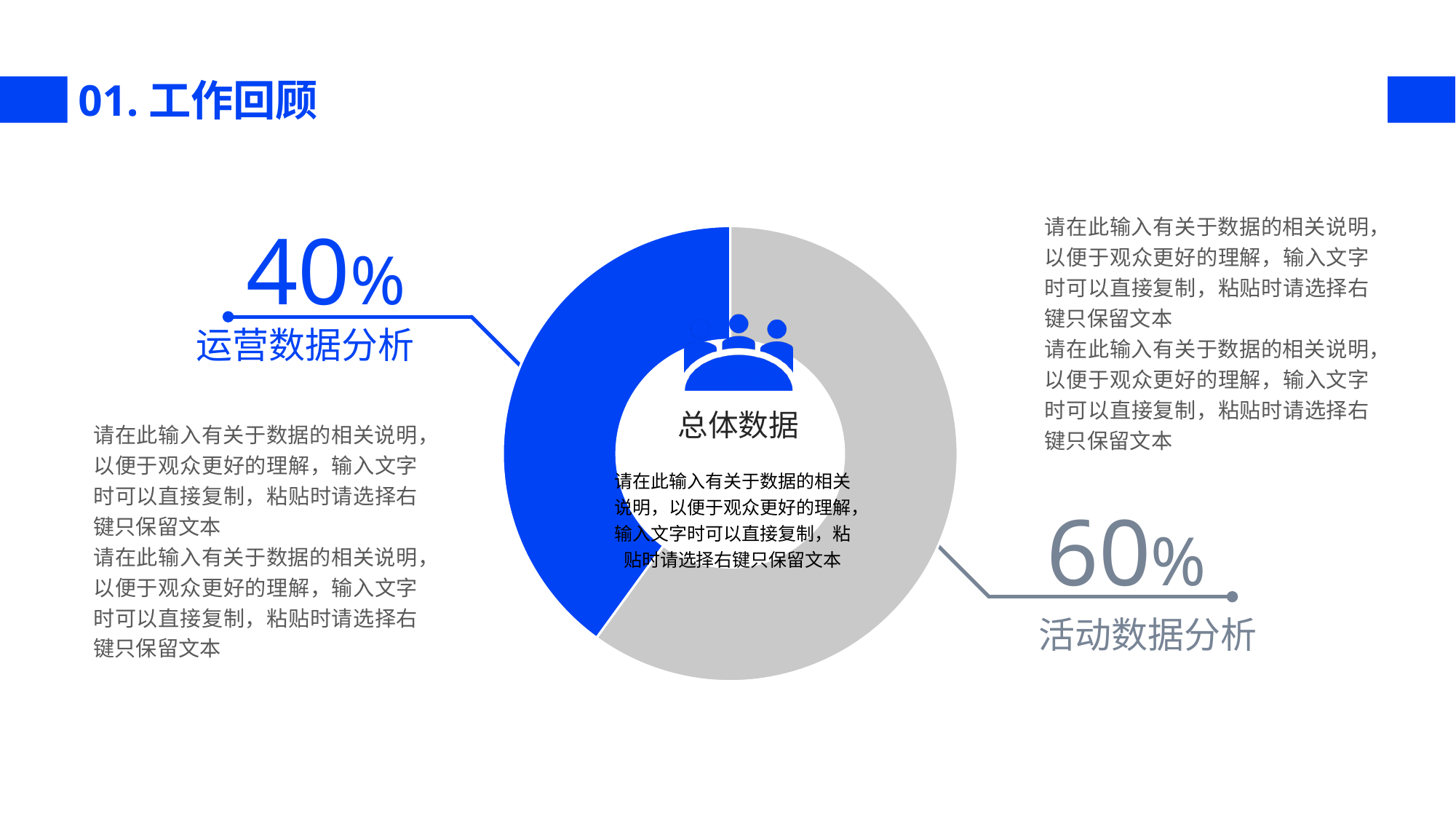
Which is larger, the share for 运营数据分析 or the share for 活动数据分析? 活动数据分析 What is the total of the two segments shown in the donut chart? 100% What percentage is shown for 运营数据分析? 40% Which segment of the donut chart is the smallest? 运营数据分析 What label appears in the centre of the donut chart? 总体数据 What is the difference between the 活动数据分析 share and the 运营数据分析 share? 20% What share of the donut chart does the blue segment represent? 40% What kind of chart is shown on the slide? Donut (pie) chart How many segments does the donut chart have? 2 What colour is the segment representing 活动数据分析? Gray What percentage is shown for 活动数据分析? 60% Which segment of the donut chart is the largest? 活动数据分析